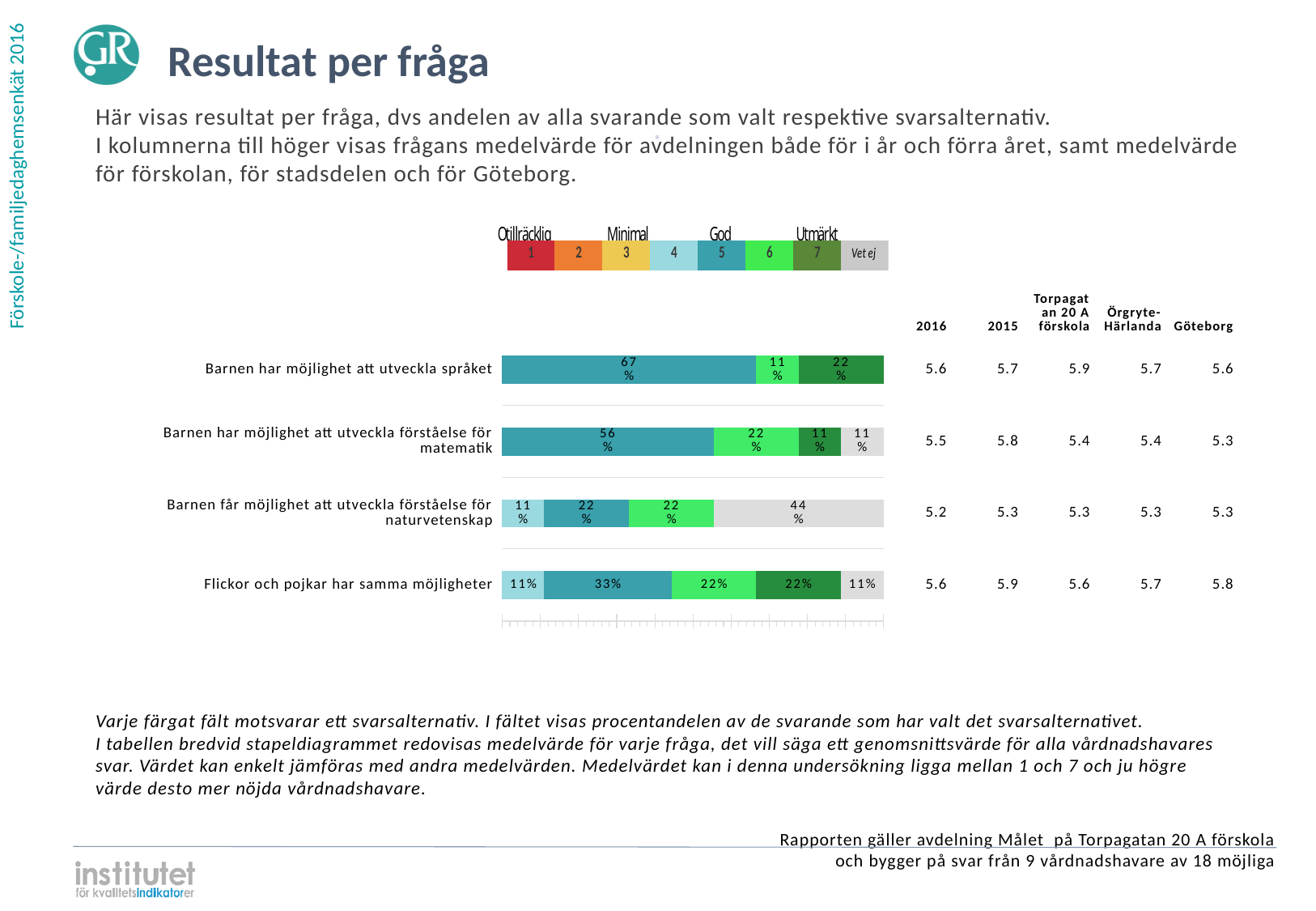
What percentage chose answer 7 (dark green) for 'Flickor och pojkar har samma möjligheter'? 22% What kind of chart is shown on the slide? Bar chart What is the combined share of answers 6 and 7 for 'Barnen har möjlighet att utveckla språket'? 33% What is the difference between the answer 5 share for 'Barnen har möjlighet att utveckla språket' (67%) and for 'Barnen har möjlighet att utveckla förståelse för matematik' (56%)? 11% What percentage chose 'Vet ej' for 'Barnen får möjlighet att utveckla förståelse för naturvetenskap'? 44% Which answer alternative is shown in red in the legend? 1 (Otillräcklig) Which is larger: the answer 5 share for 'Flickor och pojkar har samma möjligheter' or the answer 5 share for 'Barnen får möjlighet att utveckla förståelse för naturvetenskap'? Flickor och pojkar har samma möjligheter How many answer alternatives does the legend above the chart show, including 'Vet ej'? 8 How many questions (categories) are plotted in the bar chart? 4 What percentage of respondents chose answer 5 (teal) for 'Barnen har möjlighet att utveckla språket'? 67% Which question has the largest single segment in the bar chart? Barnen har möjlighet att utveckla språket What percentage chose answer 6 (bright green) for 'Barnen har möjlighet att utveckla förståelse för matematik'? 22%